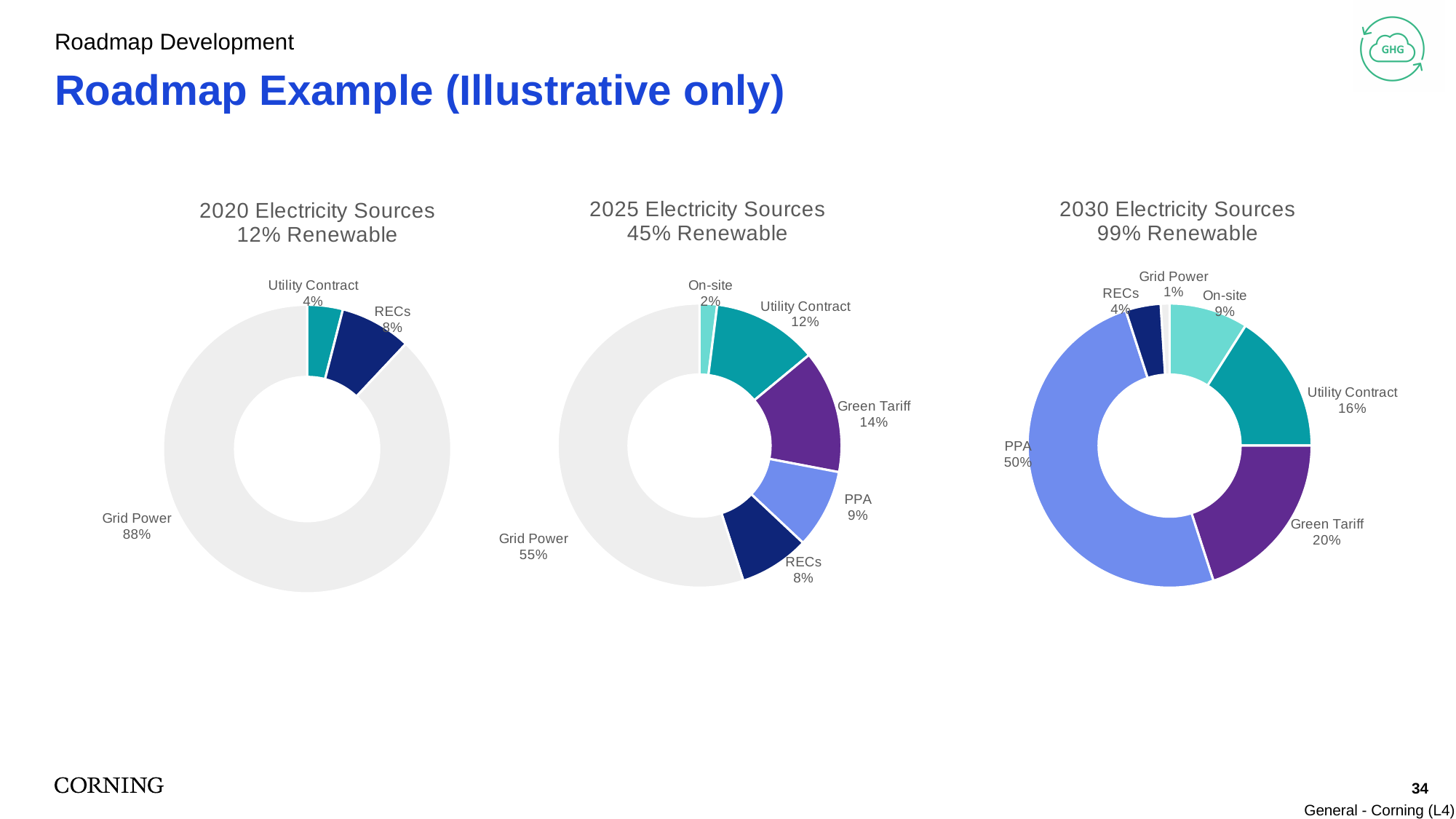
According to the chart titles, what renewable percentage is shown for 2025? 45% Renewable In the 2025 Electricity Sources chart, what is the difference between the Grid Power share and the Utility Contract share? 43% In the 2020 Electricity Sources chart, what share is Utility Contract? 4% How many slices does the 2025 Electricity Sources chart have? 6 What kind of chart is the 2020 Electricity Sources chart? Doughnut chart In the 2025 Electricity Sources chart, what share is On-site? 2% In the 2030 Electricity Sources chart, which source has the largest share? PPA In the 2030 Electricity Sources chart, which is larger, Green Tariff or Utility Contract? Green Tariff In the 2030 Electricity Sources chart, which source has the smallest share? Grid Power In the 2020 Electricity Sources chart, what share is Grid Power? 88% In the 2025 Electricity Sources chart, what share is Green Tariff? 14% In the 2030 Electricity Sources chart, what share is PPA? 50%